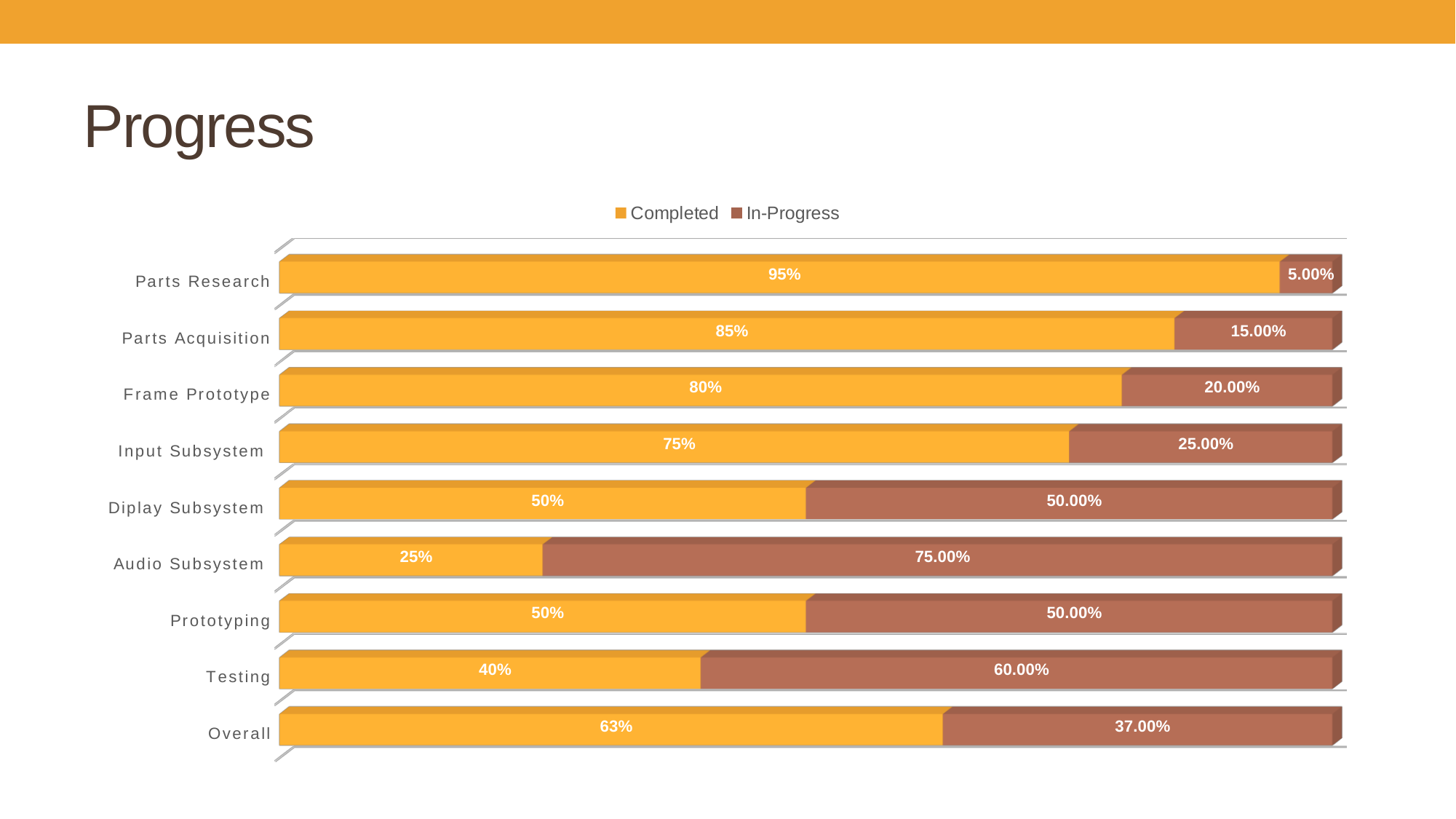
How many series does the legend list? 2 What is the Completed value for Overall? 63% What kind of chart is shown on the slide? Stacked bar chart What is the In-Progress value for Testing? 60.00% What is the Completed value for Parts Research? 95% Which category has the highest In-Progress value? Audio Subsystem Which is larger, the Completed value for Testing or the Completed value for Prototyping? Prototyping How many categories are shown on the chart? 9 What is the In-Progress value for Frame Prototype? 20.00% Which category has the highest Completed value? Parts Research Which category has the lowest Completed value? Audio Subsystem What is the difference between the Completed values for Parts Acquisition and Input Subsystem? 10%